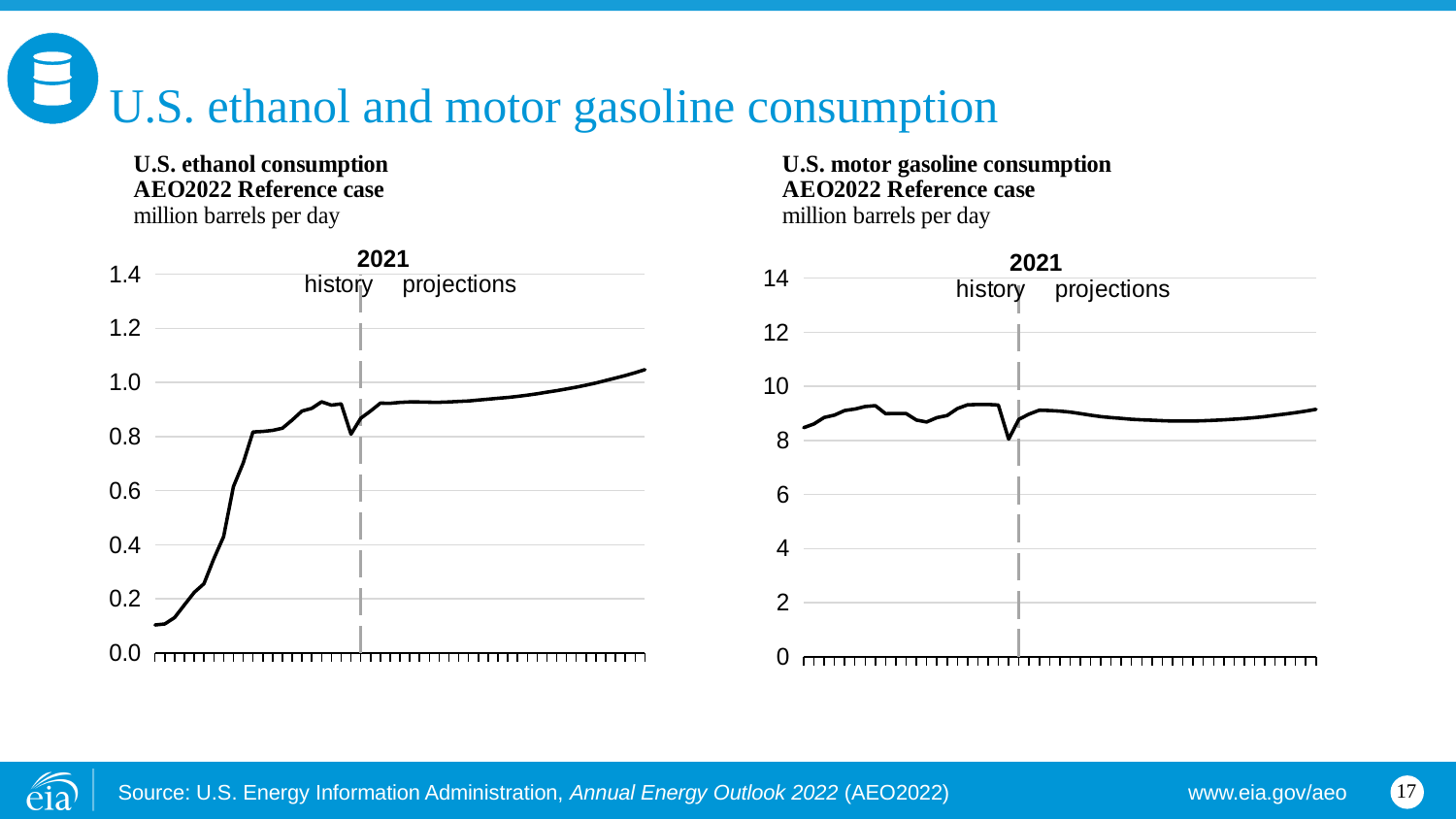
In the U.S. motor gasoline consumption chart, is the value at the start of the history period greater or less than 6? greater In the U.S. motor gasoline consumption chart, is the value at the end of the projection period greater or less than 10? less What kind of chart is the U.S. motor gasoline consumption chart on the right? line chart In the U.S. ethanol consumption chart, does the line generally rise or fall over the history period? rise What unit is used on the y axis of the U.S. motor gasoline consumption chart? million barrels per day In the U.S. ethanol consumption chart, does the line rise or fall over the projection period? rise What kind of chart is the U.S. ethanol consumption chart on the left? line chart In the U.S. ethanol consumption chart, is the value at the end of the projection period greater or less than 0.8? greater In the U.S. ethanol consumption chart, which is larger: the value at the end of the projections or the value at the start of the history period? the value at the end of the projections In the U.S. ethanol consumption chart, what year does the dashed vertical line separating history from projections mark? 2021